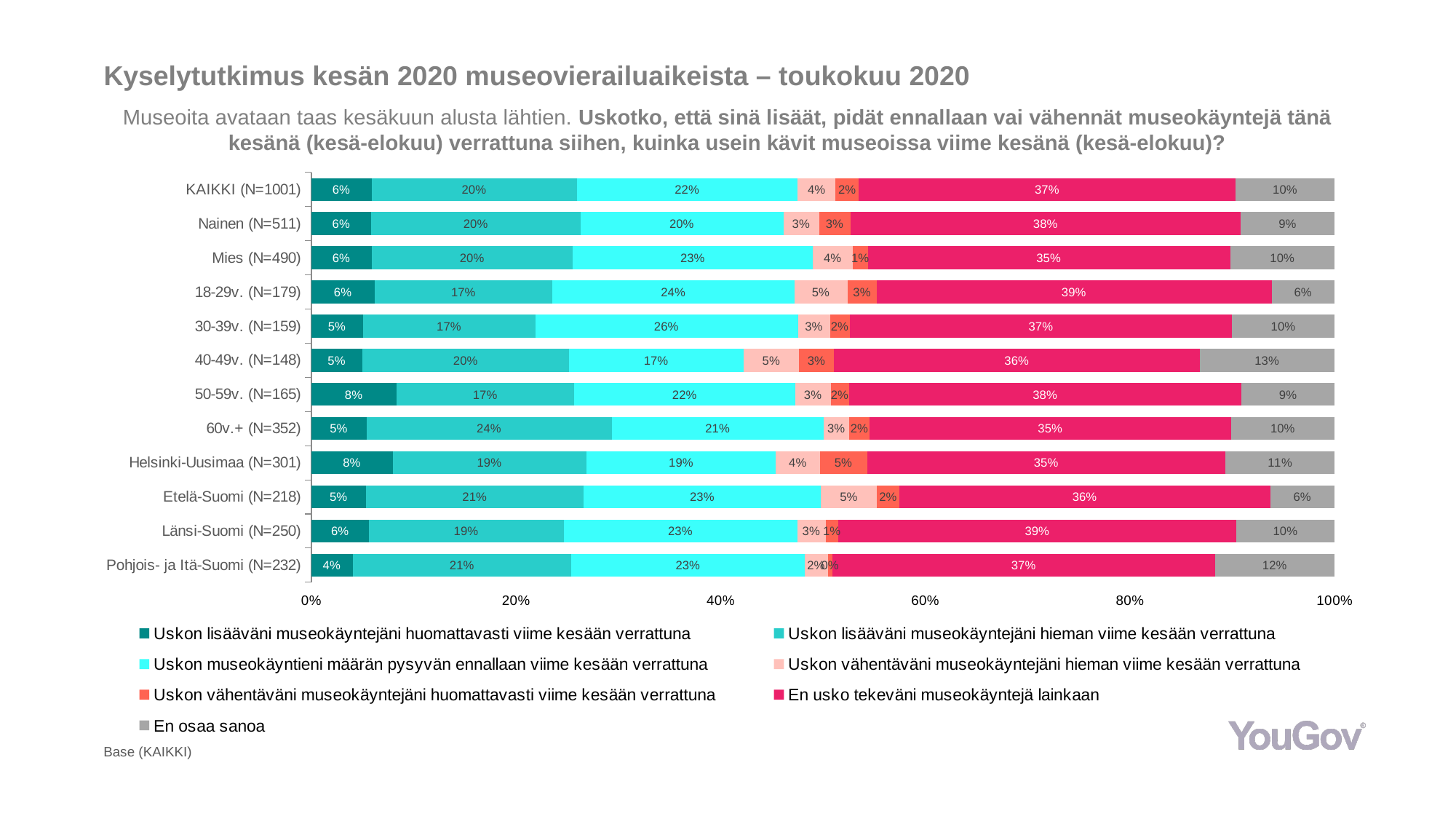
For KAIKKI (N=1001), what is the difference between 'En usko tekeväni museokäyntejä lainkaan' and 'En osaa sanoa'? 27 percentage points What is the value of 'Uskon vähentäväni museokäyntejäni huomattavasti viime kesään verrattuna' for Helsinki-Uusimaa (N=301)? 5% How many respondent groups (categories) are plotted on the chart? 12 Which group has the highest value for 'Uskon lisääväni museokäyntejäni hieman viime kesään verrattuna'? 60v.+ (N=352) What is the value of 'En usko tekeväni museokäyntejä lainkaan' for KAIKKI (N=1001)? 37% Which group has the highest 'En osaa sanoa' value? 40-49v. (N=148) Which has the larger 'En usko tekeväni museokäyntejä lainkaan' value, Nainen (N=511) or Mies (N=490)? Nainen (N=511) What kind of chart is shown on the slide? Stacked bar chart Which group has the lowest value for 'Uskon lisääväni museokäyntejäni huomattavasti viime kesään verrattuna'? Pohjois- ja Itä-Suomi (N=232) What is the value of 'Uskon museokäyntieni määrän pysyvän ennallaan viime kesään verrattuna' for 30-39v. (N=159)? 26% How many series does the legend list? 7 What is the 'En osaa sanoa' value for 40-49v. (N=148)? 13%